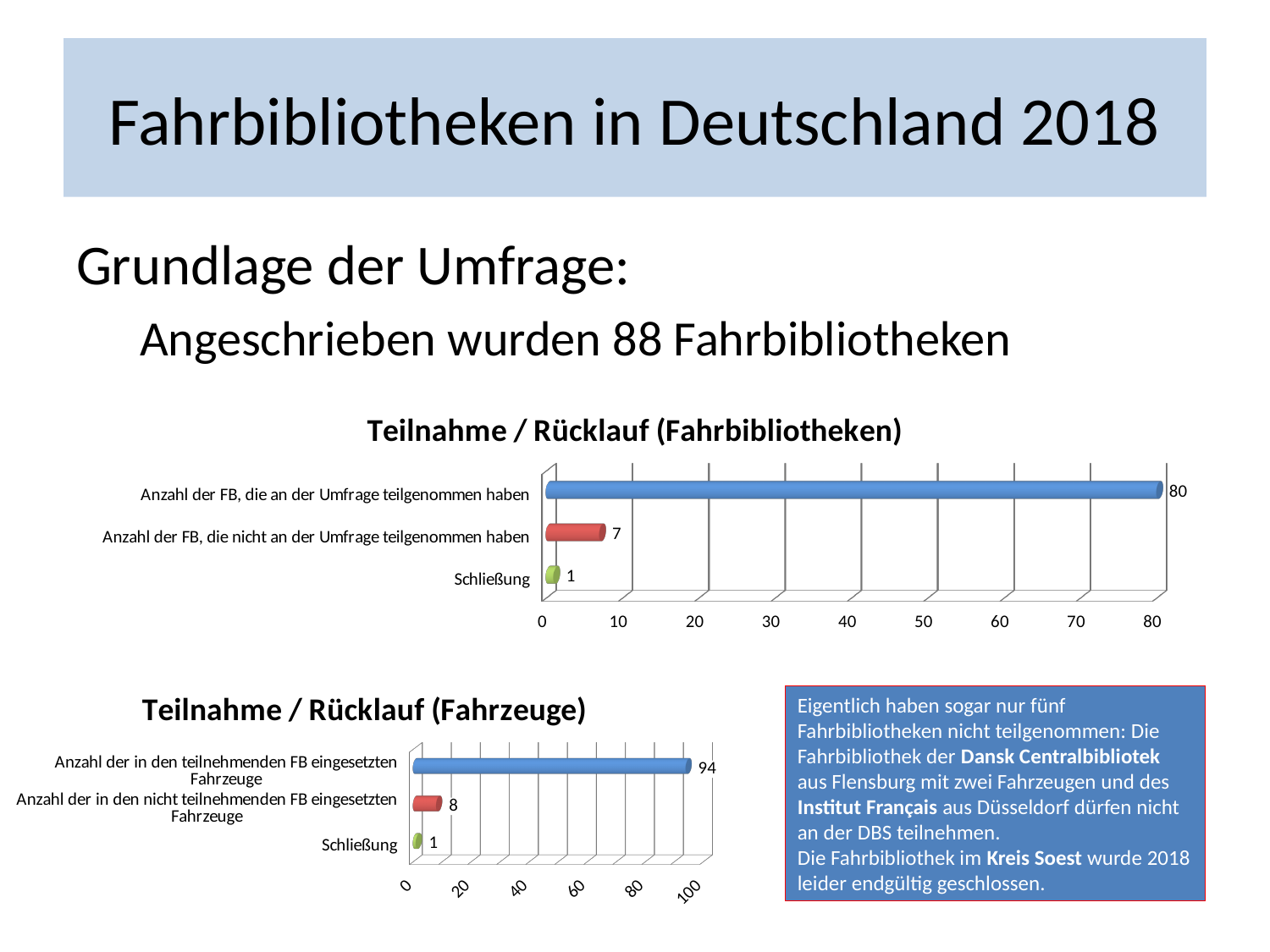
What type of chart is 'Teilnahme / Rücklauf (Fahrbibliotheken)'? Bar chart In the chart 'Teilnahme / Rücklauf (Fahrzeuge)', what is the difference between the vehicles in participating FB and the vehicles in non-participating FB? 86 In the chart 'Teilnahme / Rücklauf (Fahrbibliotheken)', what is the value for 'Anzahl der FB, die an der Umfrage teilgenommen haben'? 80 In the chart 'Teilnahme / Rücklauf (Fahrbibliotheken)', what is the value for 'Anzahl der FB, die nicht an der Umfrage teilgenommen haben'? 7 In the chart 'Teilnahme / Rücklauf (Fahrzeuge)', which category has the highest value? Anzahl der in den teilnehmenden FB eingesetzten Fahrzeuge In the chart 'Teilnahme / Rücklauf (Fahrzeuge)', what is the highest value shown on the x axis? 100 In the chart 'Teilnahme / Rücklauf (Fahrzeuge)', what is the value for 'Anzahl der in den teilnehmenden FB eingesetzten Fahrzeuge'? 94 In the chart 'Teilnahme / Rücklauf (Fahrzeuge)', what is the value for 'Anzahl der in den nicht teilnehmenden FB eingesetzten Fahrzeuge'? 8 In the chart 'Teilnahme / Rücklauf (Fahrbibliotheken)', which category has the lowest value? Schließung In the chart 'Teilnahme / Rücklauf (Fahrzeuge)', is the value for 'Schließung' larger or smaller than the value for 'Anzahl der in den nicht teilnehmenden FB eingesetzten Fahrzeuge'? Smaller In the chart 'Teilnahme / Rücklauf (Fahrbibliotheken)', how many categories are shown? 3 In the chart 'Teilnahme / Rücklauf (Fahrbibliotheken)', what is the difference between the number of FB that took part and the number that did not take part? 73